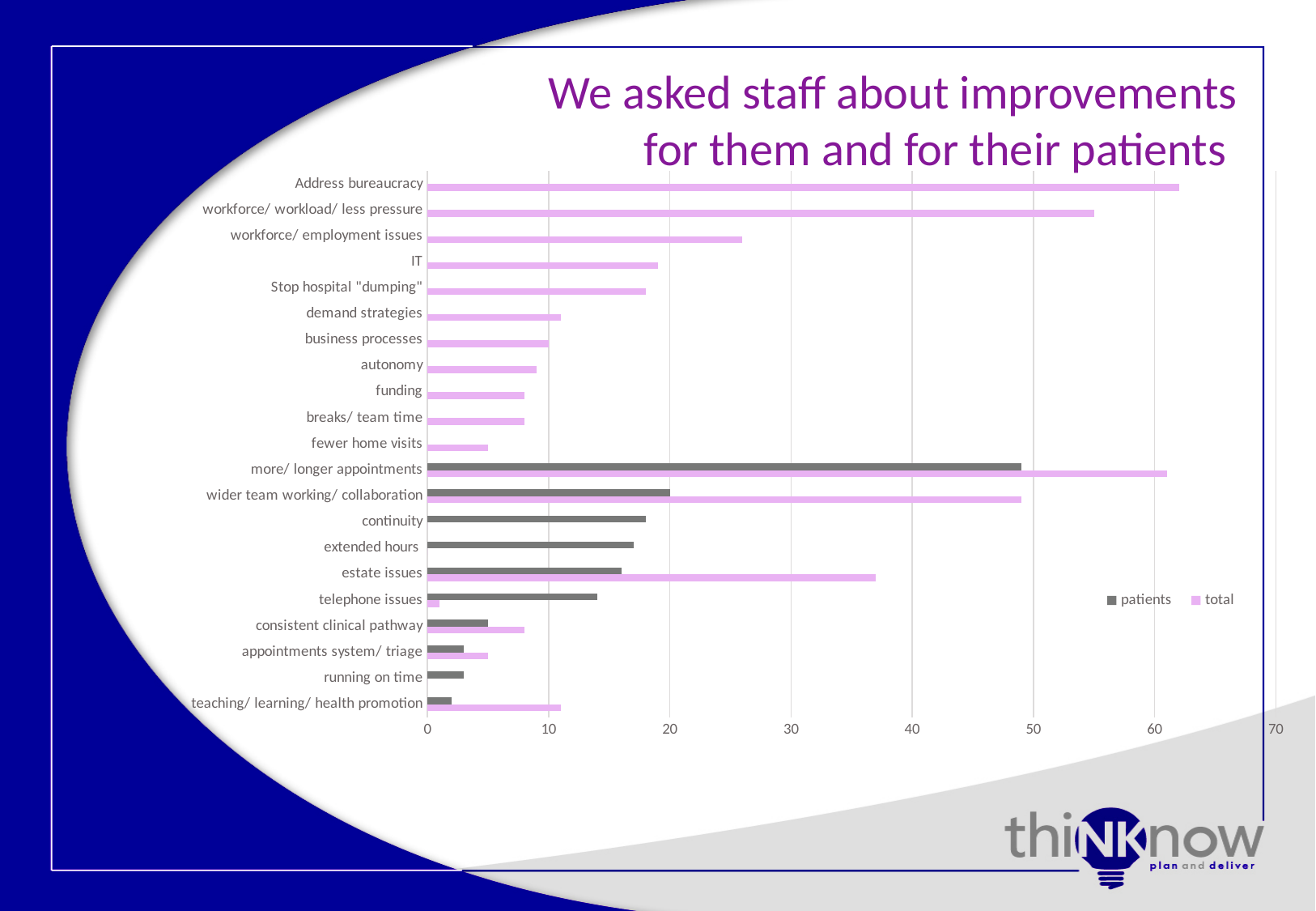
Which category has the highest value for the patients series? more/ longer appointments Is the total value for workforce/ workload/ less pressure greater or less than 50? greater Is the total value for estate issues greater or less than 40? less For estate issues, which series has the larger value, patients or total? total What are the two series named in the legend? patients and total Is the total value for IT greater or less than 20? less What kind of chart is shown on the slide? bar chart How many series does the legend list? 2 Which has the larger total value, workforce/ employment issues or IT? workforce/ employment issues How many categories are plotted on the chart? 21